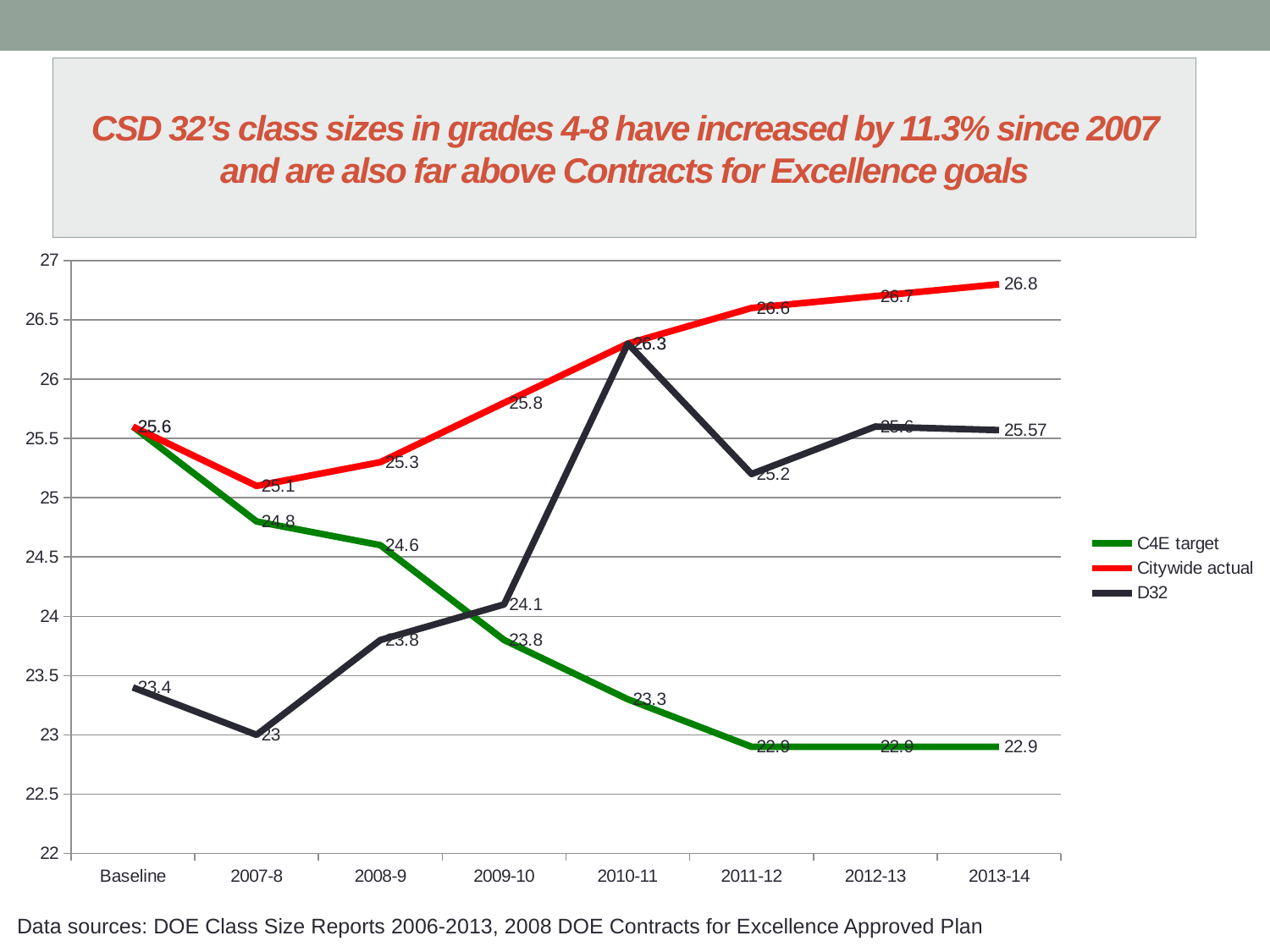
What kind of chart is shown on the slide? Line chart How many points are plotted along the x axis for each series? 8 In 2010-11, which is larger: the D32 value or the C4E target value? D32 Does the C4E target series rise or fall from Baseline to 2013-14? Fall In which year does the D32 series reach its highest value? 2010-11 What is the C4E target value for 2009-10? 23.8 What is the D32 value at Baseline? 23.4 What is the D32 value for 2013-14? 25.57 What is the Citywide actual value for 2013-14? 26.8 What colour is the D32 line in the legend? Black What is the difference between the Citywide actual value and the C4E target value in 2013-14? 3.9 How many series does the legend list? 3